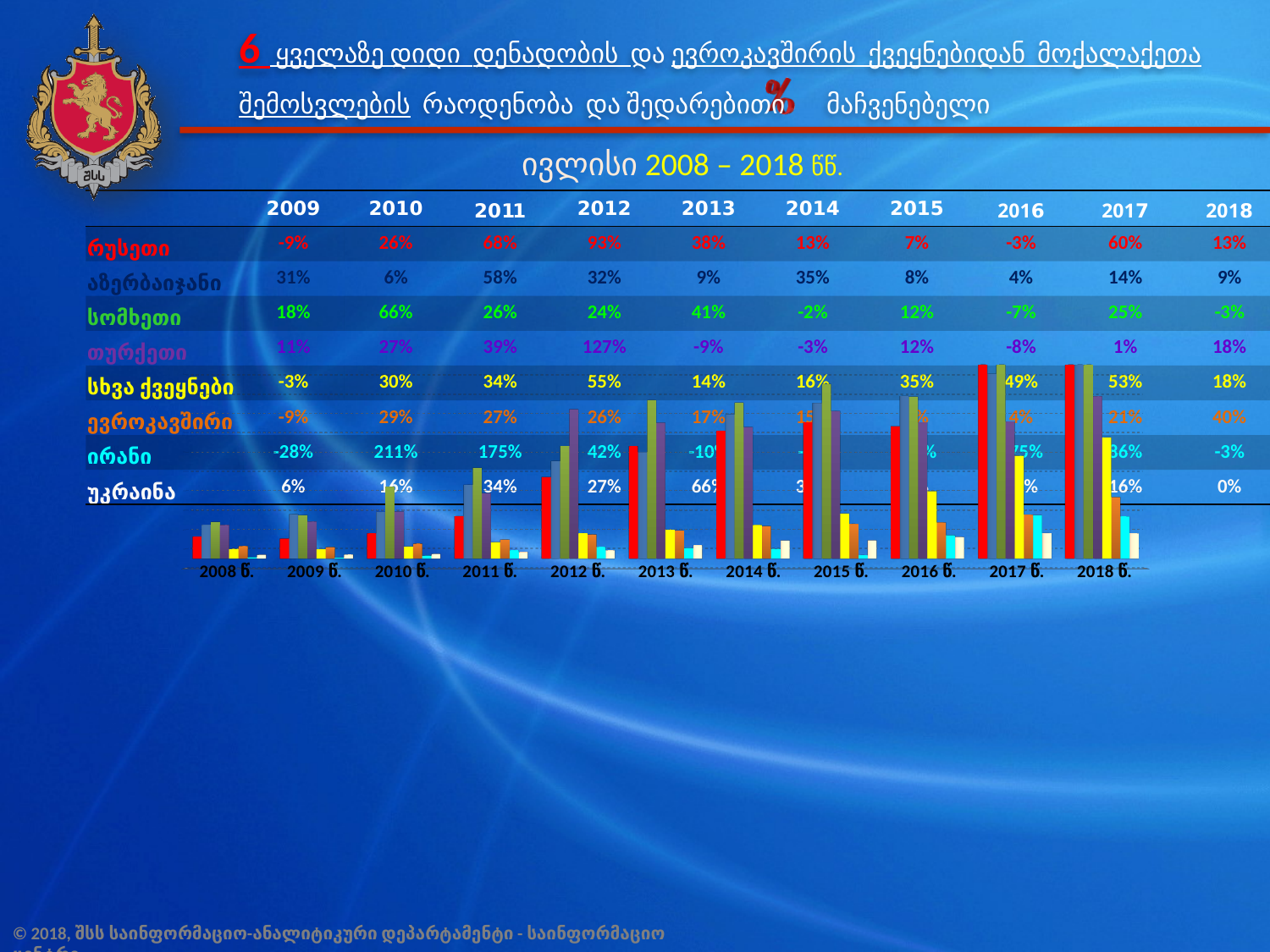
In the table above the chart, what is the value for რუსეთი in 2017? 60% How many year groups are shown along the x axis of the chart? 11 In the table above the chart, what is the value for თურქეთი in 2012? 127% What kind of chart is shown on the slide? bar chart In the table above the chart, what is the value for ირანი in 2010? 211% In the table above the chart, what is the value for სომხეთი in 2010? 66% What is the first year shown on the x axis of the chart? 2008 წ. In 2018, which bar is taller: the red one (რუსეთი) or the light blue one (ირანი)? red (რუსეთი) In the table above the chart, what is the value for უკრაინა in 2018? 0% What is the last year shown on the x axis of the chart? 2018 წ. Is the red bar (რუსეთი) taller in 2017 or in 2008? 2017 Do the red bars (რუსეთი) generally rise or fall from 2008 to 2018? rise